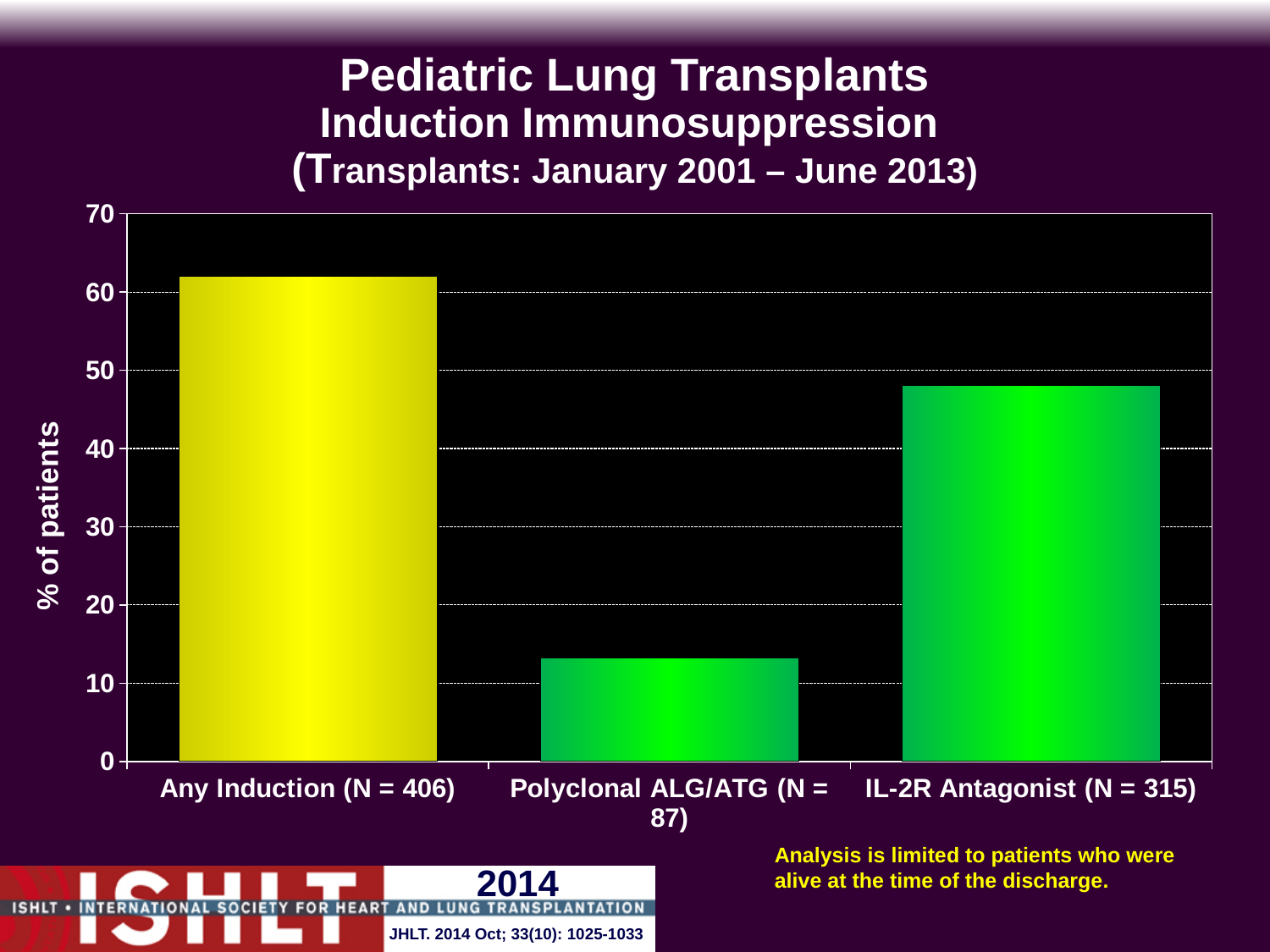
How many categories are plotted on the chart? 3 What time period of transplants does the chart title cover? January 2001 – June 2013 Which category has the lowest percentage of patients? Polyclonal ALG/ATG (N = 87) Is the value for IL-2R Antagonist (N = 315) greater or less than 50? less Which is larger, the value for IL-2R Antagonist (N = 315) or the value for Polyclonal ALG/ATG (N = 87)? IL-2R Antagonist (N = 315) What kind of chart is shown on the slide? bar chart Is the value for IL-2R Antagonist (N = 315) greater or less than 40? greater Is the value for Polyclonal ALG/ATG (N = 87) greater or less than 10? greater What is the label of the y axis? % of patients Which category has the highest percentage of patients? Any Induction (N = 406)